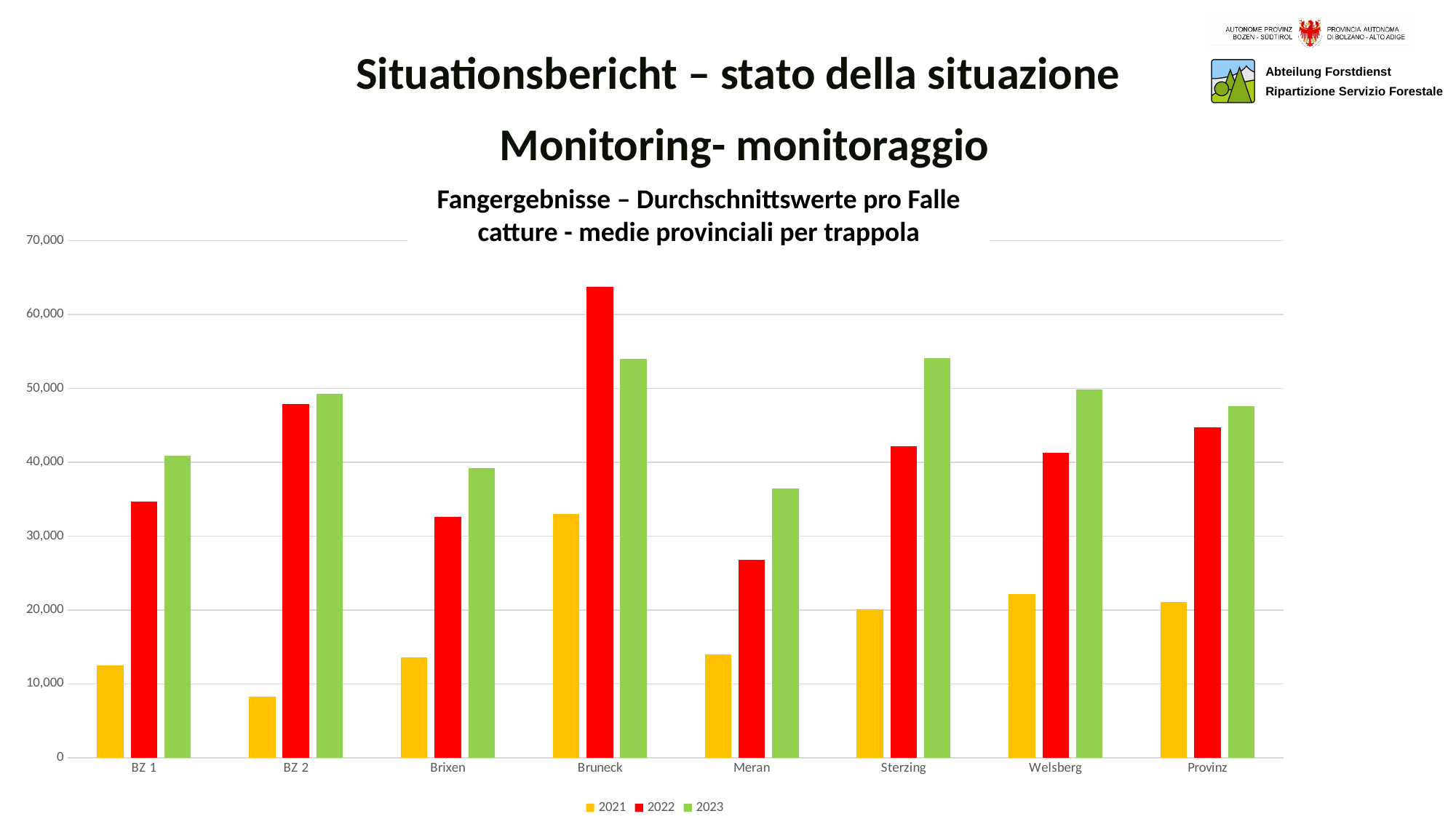
For Meran, do the values rise or fall from 2021 to 2023? rise Which category has the highest value for the 2021 series? Bruneck Is the 2021 value for BZ 2 greater or less than 10,000? less For Bruneck, which is larger: the 2022 value or the 2023 value? 2022 What kind of chart is shown on the slide? bar chart Which category has the lowest value for the 2023 series? Meran Which category has the highest value for the 2022 series? Bruneck Which colour represents the 2023 series in the legend? green How many categories are shown on the x axis of the chart? 8 Which category has the lowest value for the 2021 series? BZ 2 How many series does the legend list? 3 Is the 2022 value for Bruneck greater or less than 60,000? greater